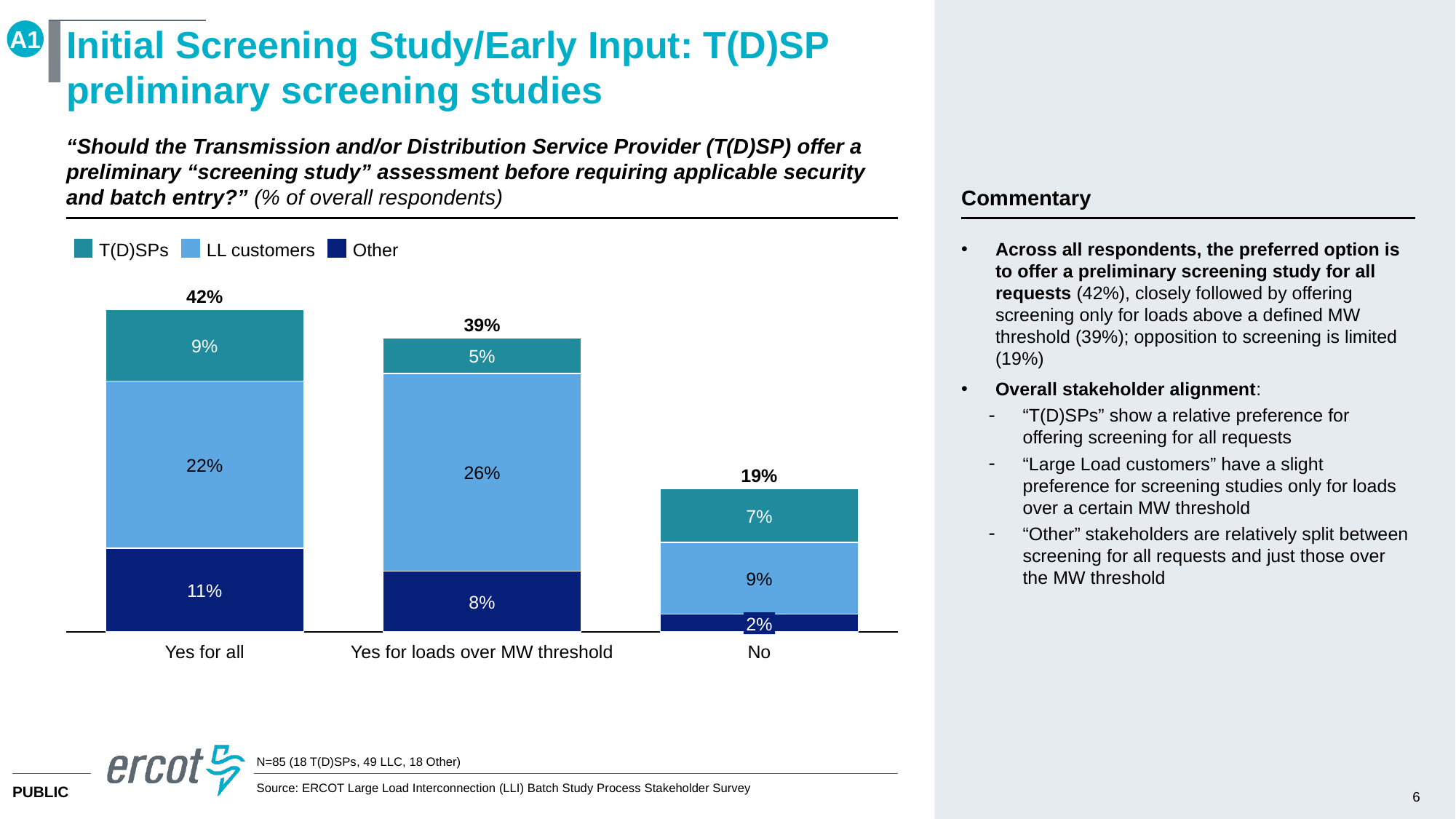
What kind of chart is shown? Stacked bar chart What is the difference between the totals for "Yes for all" and "Yes for loads over MW threshold"? 3% Which series is shown in dark navy blue? Other How many categories are shown on the x axis? 3 Which category has the highest total? Yes for all What is the total for the "Yes for all" bar? 42% Which category has the lowest total? No How many series does the legend list? 3 What is the T(D)SPs value for "No"? 7% What is the Other value for "Yes for all"? 11% Which is larger: the T(D)SPs value for "Yes for all" or for "Yes for loads over MW threshold"? Yes for all What is the LL customers value for "Yes for loads over MW threshold"? 26%